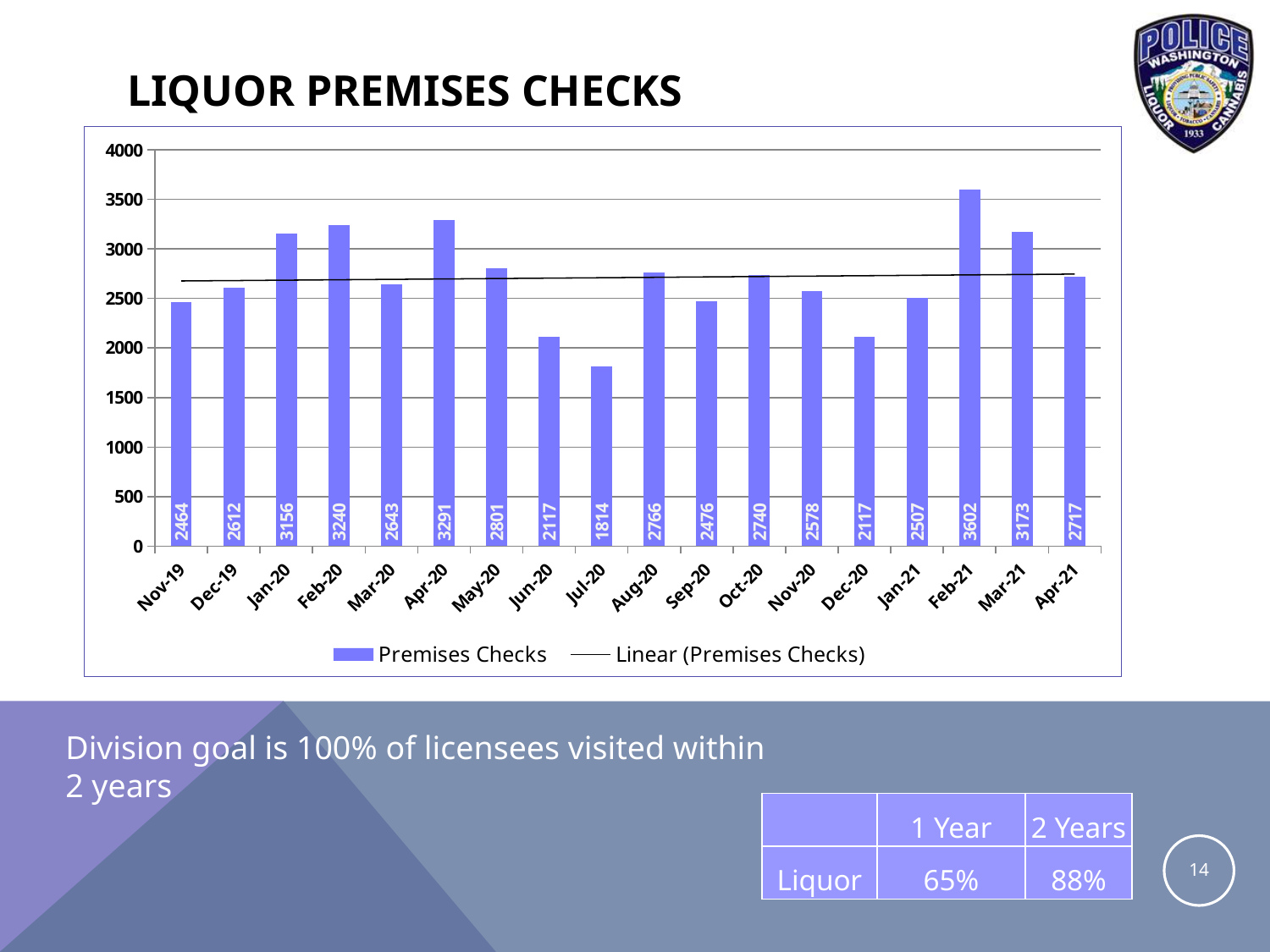
Which month had more premises checks, Jan-20 or Sep-20? Jan-20 How many premises checks were recorded in Jul-20? 1814 What is the value of Premises Checks for Feb-21? 3602 How many months are shown on the x axis of the chart? 18 What is the difference between the premises checks in Feb-21 and Jul-20? 1788 What is the difference between the premises checks in Apr-20 and Mar-20? 648 What type of chart is used to show the premises checks? Bar chart How many entries does the chart legend list? 2 Which month has the lowest number of premises checks? Jul-20 Which month has the highest number of premises checks? Feb-21 What is the value of Premises Checks for Apr-20? 3291 Is the value for Jul-20 greater or less than 2000? less